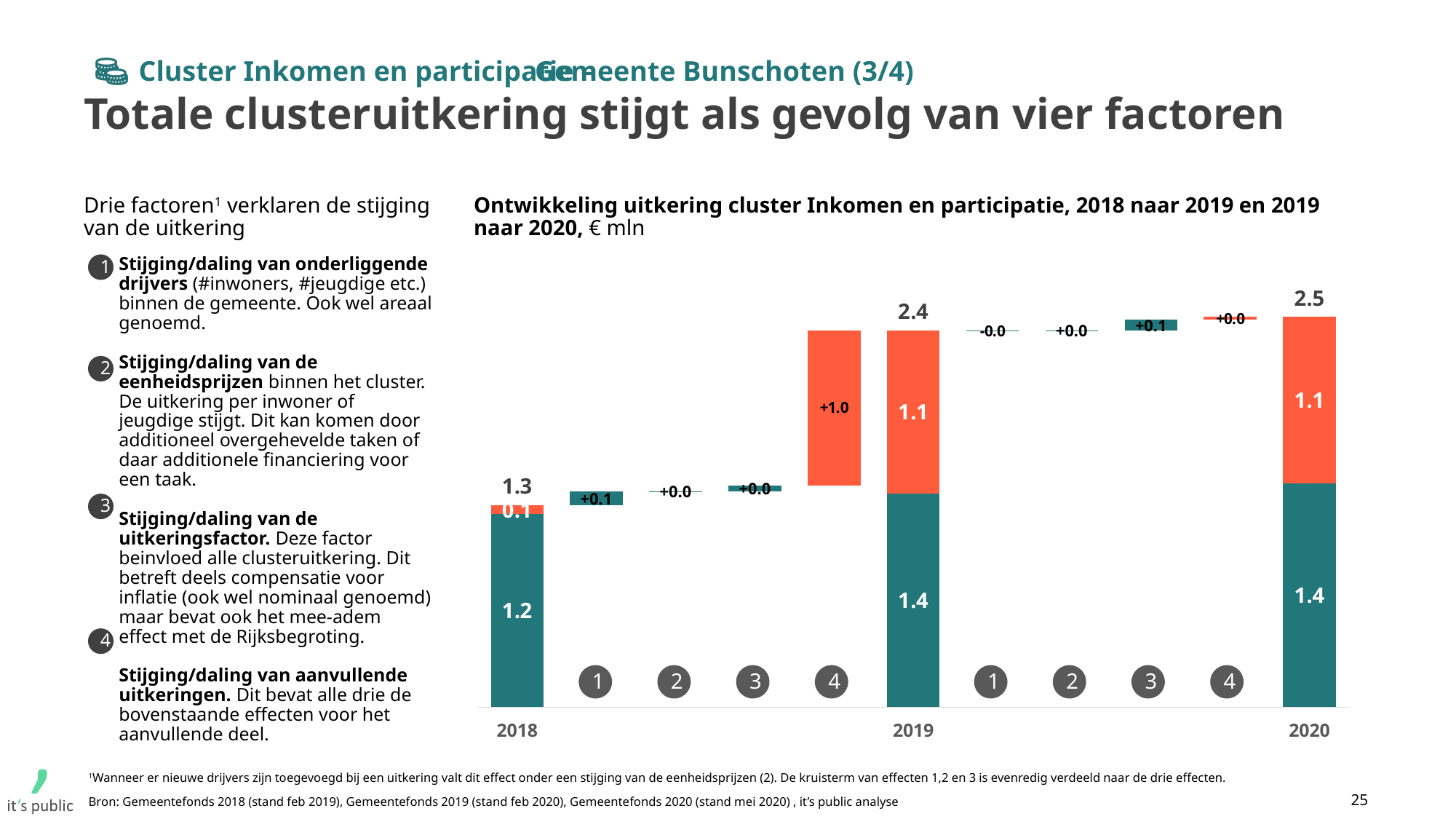
Which of the four steps between 2018 and 2019 is the largest? 4 Do the year totals rise or fall from 2018 to 2020? rise What is the difference between the 2019 total and the 2018 total? 1.1 What is the value of the step labelled 3 between 2019 and 2020? +0.1 What is the value of the step labelled 4 between 2018 and 2019? +1.0 What is the total value shown above the 2019 bar? 2.4 Which year has the highest total value? 2020 What is the value of the teal (lower) segment of the 2019 bar? 1.4 What is the total value shown above the 2020 bar? 2.5 What is the value of the orange (upper) segment of the 2018 bar? 0.1 What is the total value shown above the 2018 bar? 1.3 Which year has the lowest total value? 2018